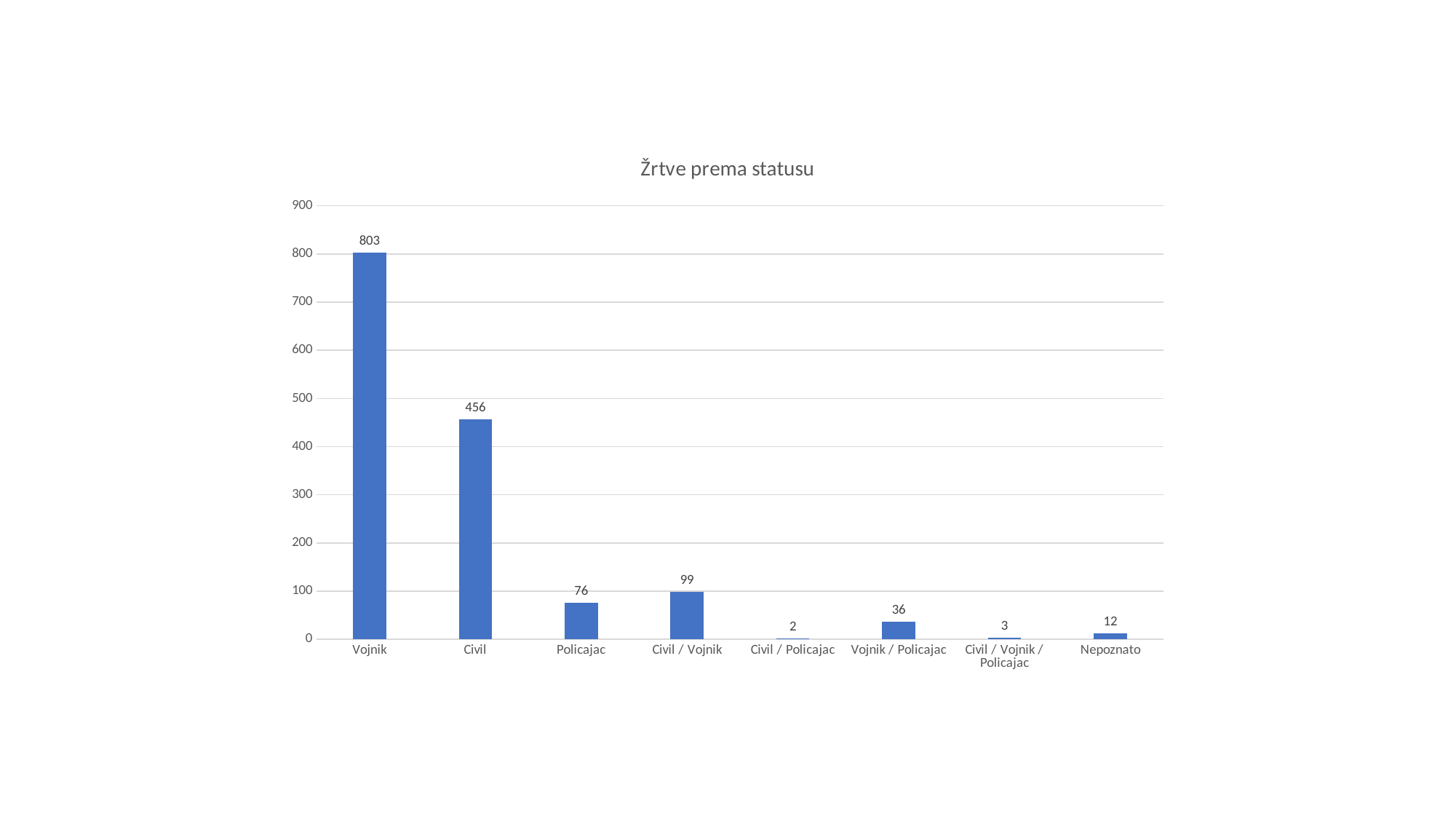
Which category has the highest value? Vojnik Which is larger, the value for Policajac or the value for Civil / Vojnik? Civil / Vojnik What is the value for Civil / Vojnik? 99 What kind of chart is shown? Bar chart What is the difference between the values for Vojnik and Civil? 347 What is the value for Nepoznato? 12 What is the value for Vojnik? 803 Which category has the lowest value? Civil / Policajac What is the title of the chart? Žrtve prema statusu How many categories are shown on the x axis? 8 Is the value for Civil greater or less than 400? greater What is the value for Civil? 456